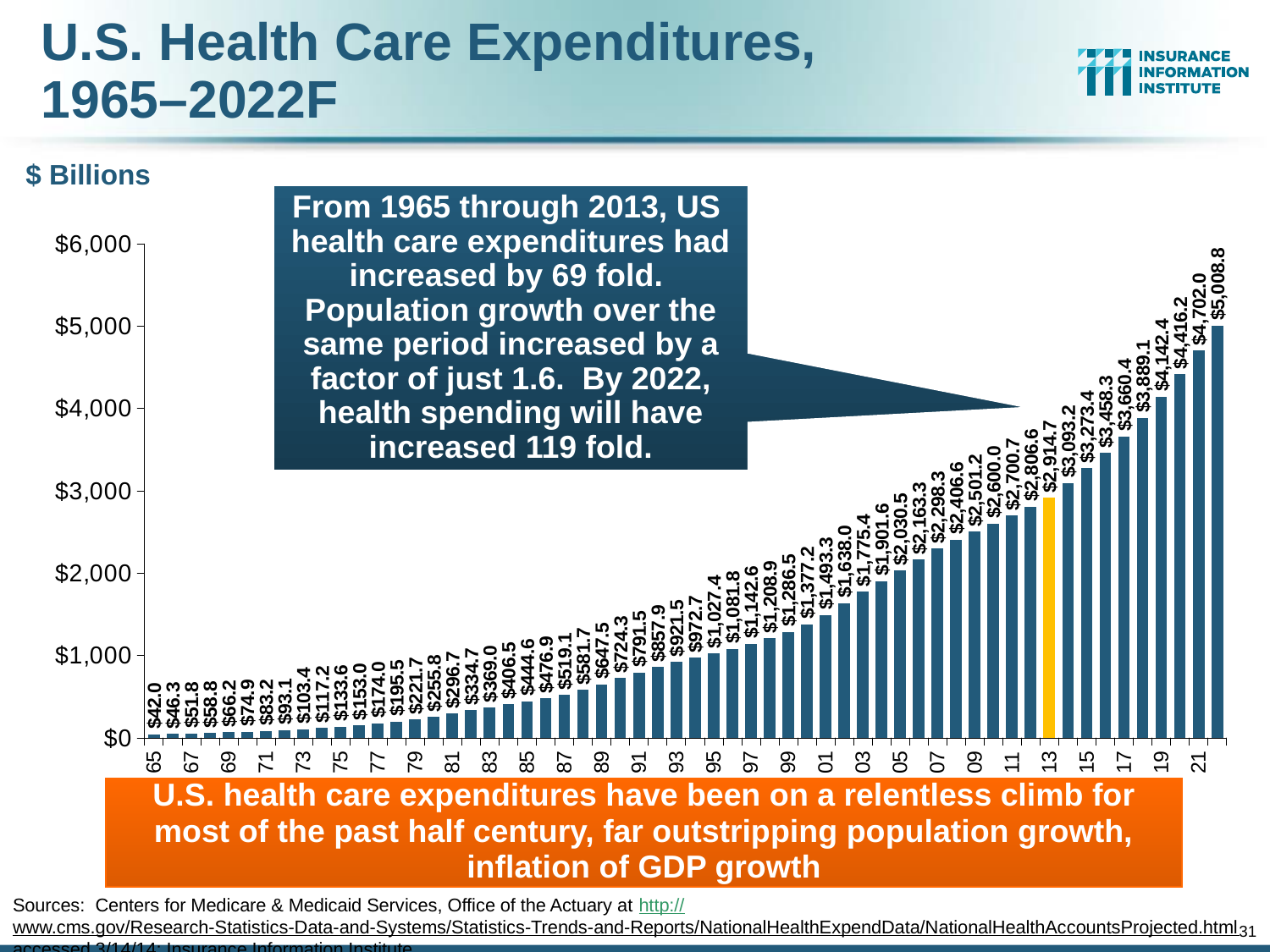
Which year has the highest value in the chart? 2022 (22) What is the value of the first bar (1965) in the chart? $42.0 What is the value of the highlighted (yellow) bar for 2013? $2,914.7 What is the difference between the 2022F value and the 1965 value? $4,966.8 Which is larger, the value for 2005 (05) or the value for 1995 (95)? 2005 (05) Which year has the lowest value in the chart? 1965 (65) Do the values rise or fall from left to right along the x axis? Rise Is the value for 2017 (17) greater or less than $3,000? greater How many bars (years) are plotted in the chart? 58 What is the value shown for the last bar (2022F)? $5,008.8 What is the value shown for the year 2000 (labelled 01 is the next bar; the bar labelled 99 is 1999)? Give the value for the bar labelled 99. $1,286.5 What kind of chart is shown on the slide? Bar chart